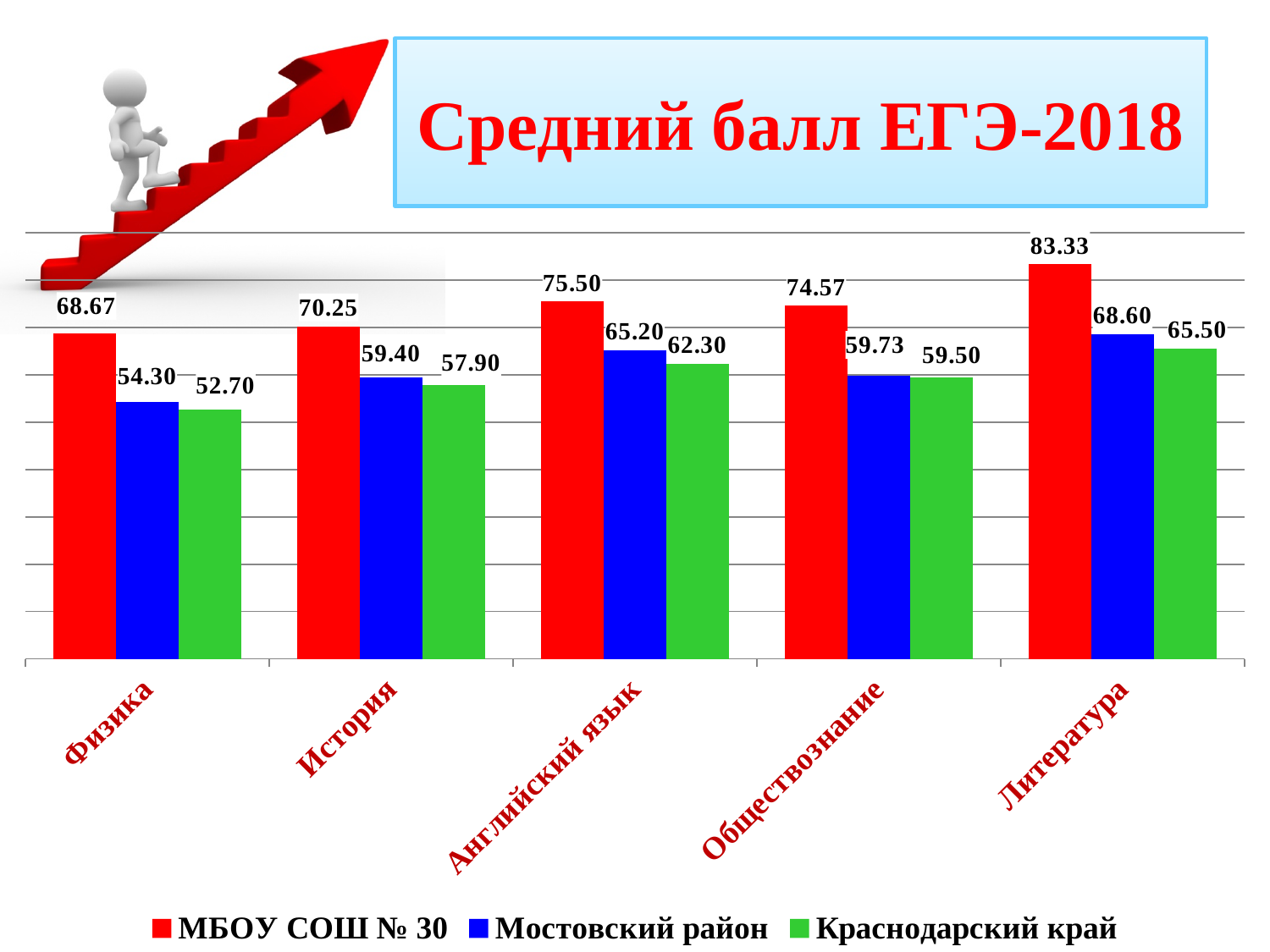
What is the value for Мостовский район in Физика? 54.30 What is the value for МБОУ СОШ № 30 in Литература? 83.33 What is the value for Краснодарский край in Английский язык? 62.30 How many series does the legend list? 3 Which subject has the lowest value for Краснодарский край? Физика What is the difference between МБОУ СОШ № 30 and Мостовский район in Обществознание? 14.84 What is the difference between Мостовский район and Краснодарский край in История? 1.50 What kind of chart is shown on the slide? Bar chart How many subjects are shown on the x axis? 5 Which is larger in Английский язык: the value for Мостовский район or for Краснодарский край? Мостовский район What is the title of the chart? Средний балл ЕГЭ-2018 Which subject has the highest value for МБОУ СОШ № 30? Литература